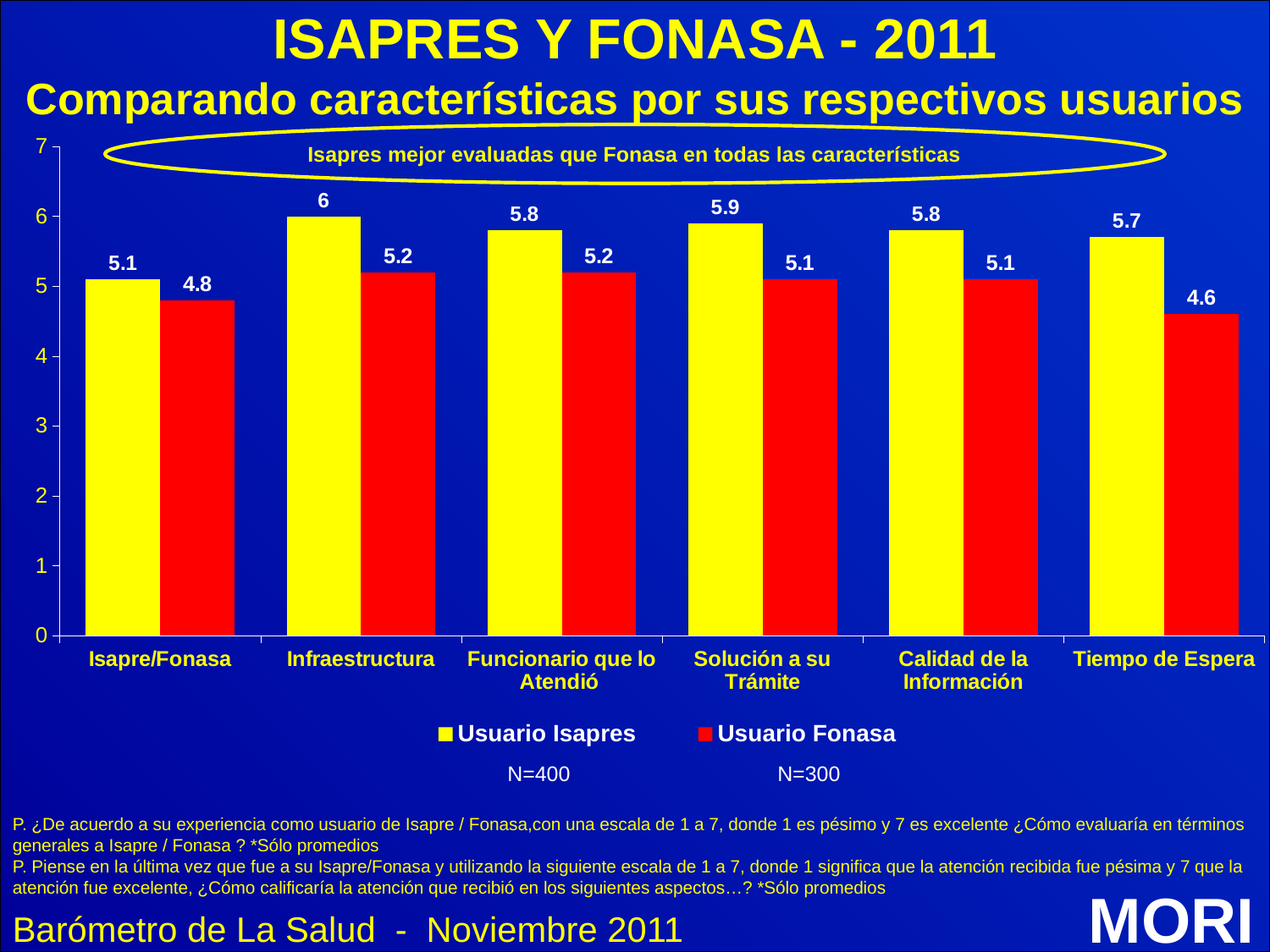
What kind of chart is shown on the slide? Bar chart Which category has the lowest value for Usuario Fonasa? Tiempo de Espera How many categories are shown on the x axis? 6 How many series does the legend list? 2 What is the value for Usuario Isapres in the Infraestructura category? 6 Is the value for Usuario Fonasa in the Infraestructura category greater or less than 5? greater What is the difference between Usuario Isapres and Usuario Fonasa in the Solución a su Trámite category? 0.8 What is the difference between Usuario Isapres and Usuario Fonasa in the Tiempo de Espera category? 1.1 What is the value for Usuario Fonasa in the Tiempo de Espera category? 4.6 Which category has the highest value for Usuario Isapres? Infraestructura What is the value for Usuario Fonasa in the Isapre/Fonasa category? 4.8 Which is larger in the Calidad de la Información category: Usuario Isapres or Usuario Fonasa? Usuario Isapres